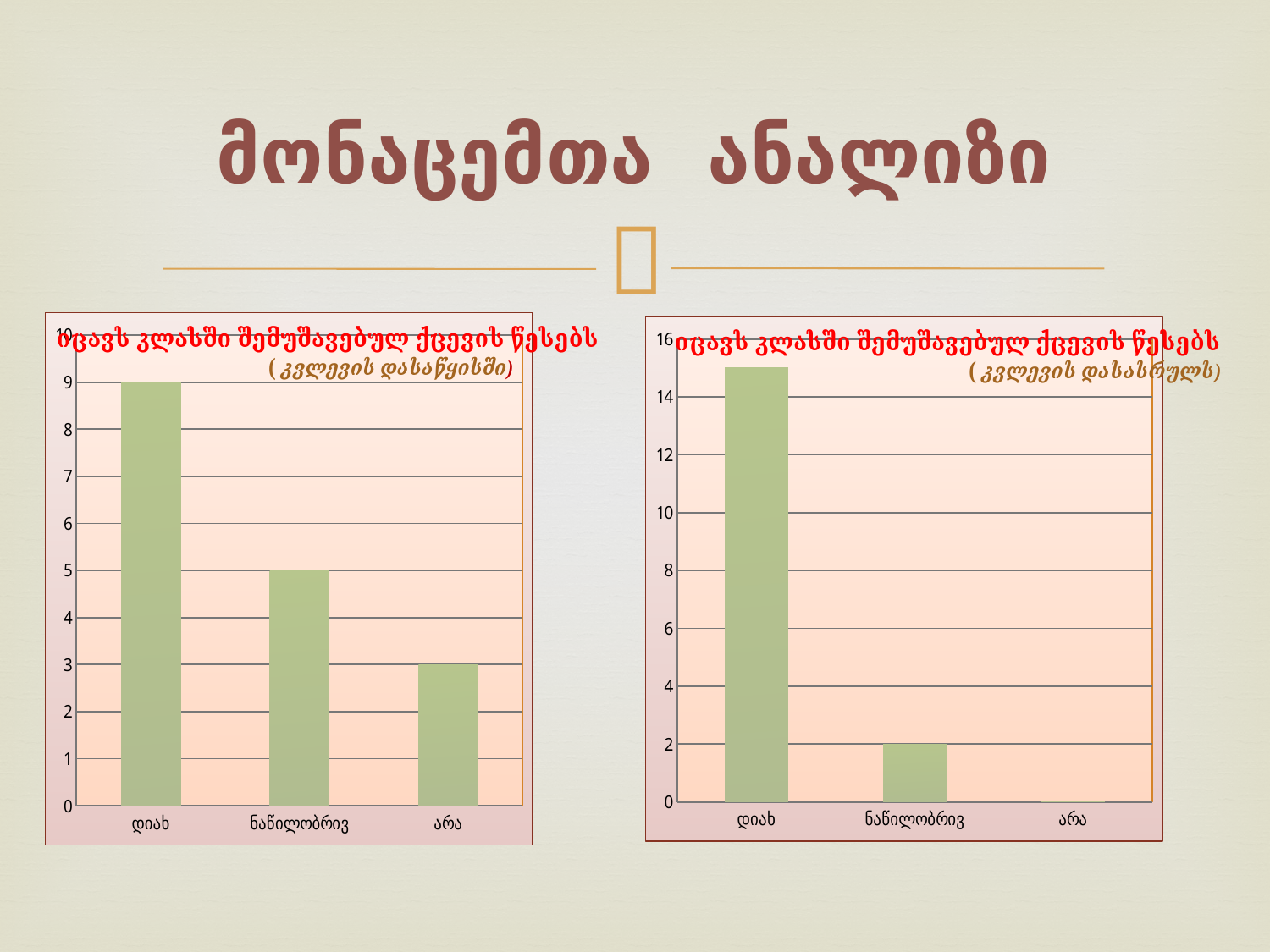
In the right chart (კვლევის დასასრულს), is the value for დიახ greater or less than 14? greater What type of chart is the right chart (კვლევის დასასრულს)? bar chart In the left chart (კვლევის დასაწყისში), which category has the lowest value? არა In the right chart (კვლევის დასასრულს), which category has the highest value? დიახ In the left chart (კვლევის დასაწყისში), what is the value for დიახ? 9 In the left chart (კვლევის დასაწყისში), what is the value for ნაწილობრივ? 5 In the right chart (კვლევის დასასრულს), which is larger, the value for ნაწილობრივ or the value for არა? ნაწილობრივ In the left chart (კვლევის დასაწყისში), what is the difference between the values for დიახ and ნაწილობრივ? 4 In the right chart (კვლევის დასასრულს), what is the value for ნაწილობრივ? 2 In the left chart (კვლევის დასაწყისში), which category has the highest value? დიახ In the left chart (კვლევის დასაწყისში), what is the value for არა? 3 How many categories are shown on the x axis of the left chart (კვლევის დასაწყისში)? 3